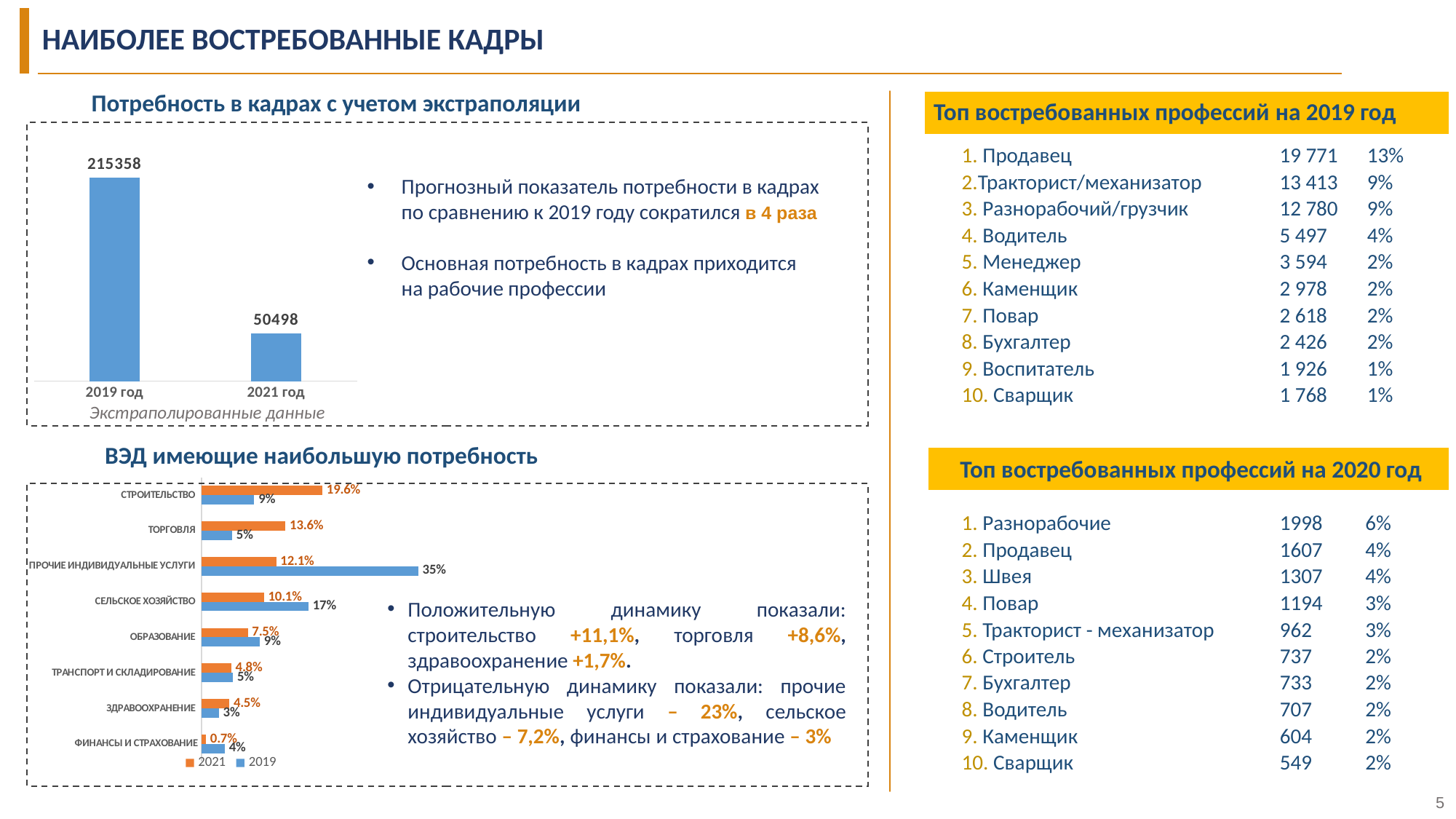
What kind of chart is 'Потребность в кадрах с учетом экстраполяции'? Bar chart In the chart 'ВЭД имеющие наибольшую потребность', how many series does the legend list? 2 In the chart 'ВЭД имеющие наибольшую потребность', which category has the highest 2021 value? Строительство In the chart 'Потребность в кадрах с учетом экстраполяции', what is the difference between the 2019 год and 2021 год values? 164860 In the chart 'ВЭД имеющие наибольшую потребность', what is the 2019 value for Прочие индивидуальные услуги? 35% In the chart 'ВЭД имеющие наибольшую потребность', how many categories are shown? 8 In the chart 'ВЭД имеющие наибольшую потребность', what is the 2021 value for Строительство? 19.6% In the chart 'Потребность в кадрах с учетом экстраполяции', what is the value for 2021 год? 50498 In the chart 'ВЭД имеющие наибольшую потребность', which category has the highest 2019 value? Прочие индивидуальные услуги In the chart 'Потребность в кадрах с учетом экстраполяции', what is the value for 2019 год? 215358 In the chart 'ВЭД имеющие наибольшую потребность', which category has the lowest 2021 value? Финансы и страхование In the chart 'ВЭД имеющие наибольшую потребность', is the 2019 value for Сельское хозяйство larger or smaller than its 2021 value? Larger